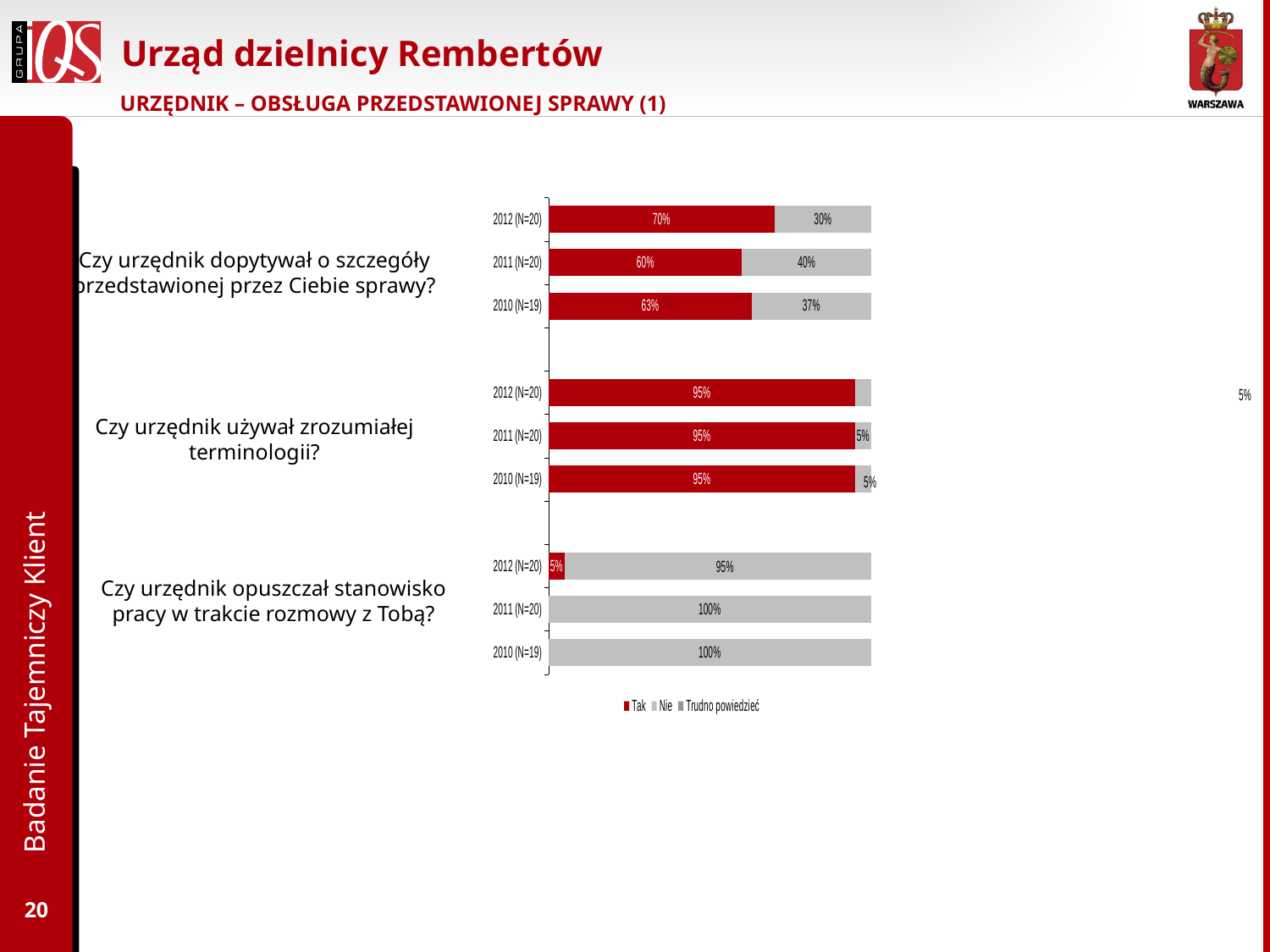
In the chart for "Czy urzędnik dopytywał o szczegóły przedstawionej przez Ciebie sprawy?", which year has the highest share of "Tak" answers? 2012 (N=20) In the chart for "Czy urzędnik dopytywał o szczegóły przedstawionej przez Ciebie sprawy?", which year has the lowest share of "Tak" answers? 2011 (N=20) In the chart for "Czy urzędnik używał zrozumiałej terminologii?", what percentage answered "Tak" in 2011 (N=20)? 95% In the chart for "Czy urzędnik dopytywał o szczegóły przedstawionej przez Ciebie sprawy?", what percentage answered "Tak" in 2012 (N=20)? 70% How many series does the legend list for the charts on this slide? 3 In the chart for "Czy urzędnik opuszczał stanowisko pracy w trakcie rozmowy z Tobą?", what percentage answered "Nie" in 2011 (N=20)? 100% In the chart for "Czy urzędnik dopytywał o szczegóły przedstawionej przez Ciebie sprawy?", what is the difference in percentage points between the "Tak" share in 2012 and in 2011? 10 percentage points In the chart for "Czy urzędnik dopytywał o szczegóły przedstawionej przez Ciebie sprawy?", what percentage answered "Tak" in 2010 (N=19)? 63% What type of chart is used on this slide? Stacked bar chart In the chart for "Czy urzędnik opuszczał stanowisko pracy w trakcie rozmowy z Tobą?", what percentage answered "Nie" in 2012 (N=20)? 95% In the chart for "Czy urzędnik opuszczał stanowisko pracy w trakcie rozmowy z Tobą?", what percentage answered "Tak" in 2012 (N=20)? 5% In the chart for "Czy urzędnik dopytywał o szczegóły przedstawionej przez Ciebie sprawy?", what percentage answered "Nie" in 2011 (N=20)? 40%